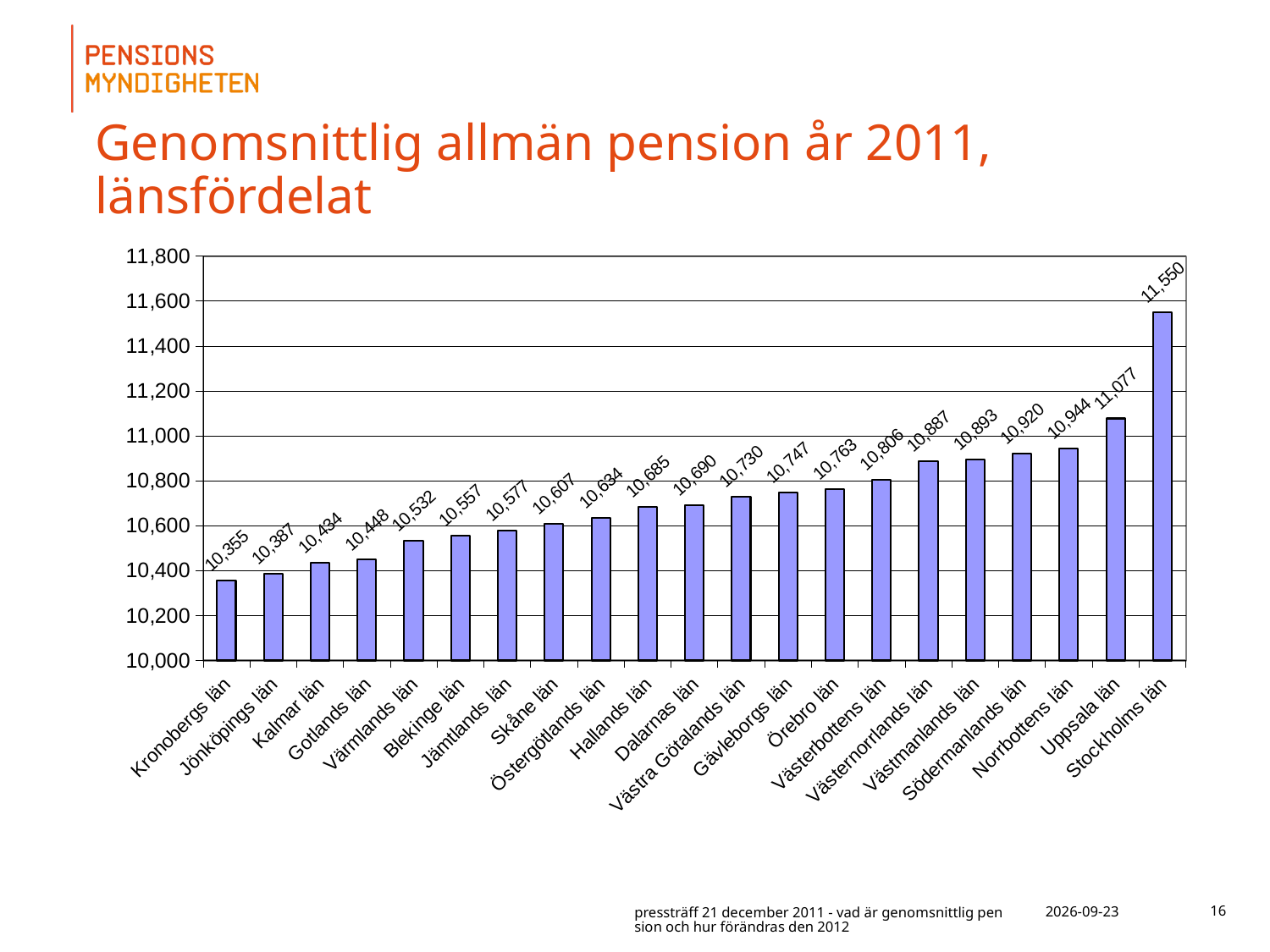
What is the value for Västra Götalands län? 10,730 Which county has the highest value? Stockholms län Is the value for Västernorrlands län greater or less than 11,000? less What is the difference between the values for Stockholms län and Kronobergs län? 1,195 What is the value for Stockholms län? 11,550 What is the difference between the values for Uppsala län and Norrbottens län? 133 Which is larger, the value for Hallands län or the value for Blekinge län? Hallands län What is the value for Gotlands län? 10,448 What is the value for Skåne län? 10,607 What kind of chart is shown on the slide? bar chart How many counties are shown in the chart? 21 Which county has the lowest value? Kronobergs län